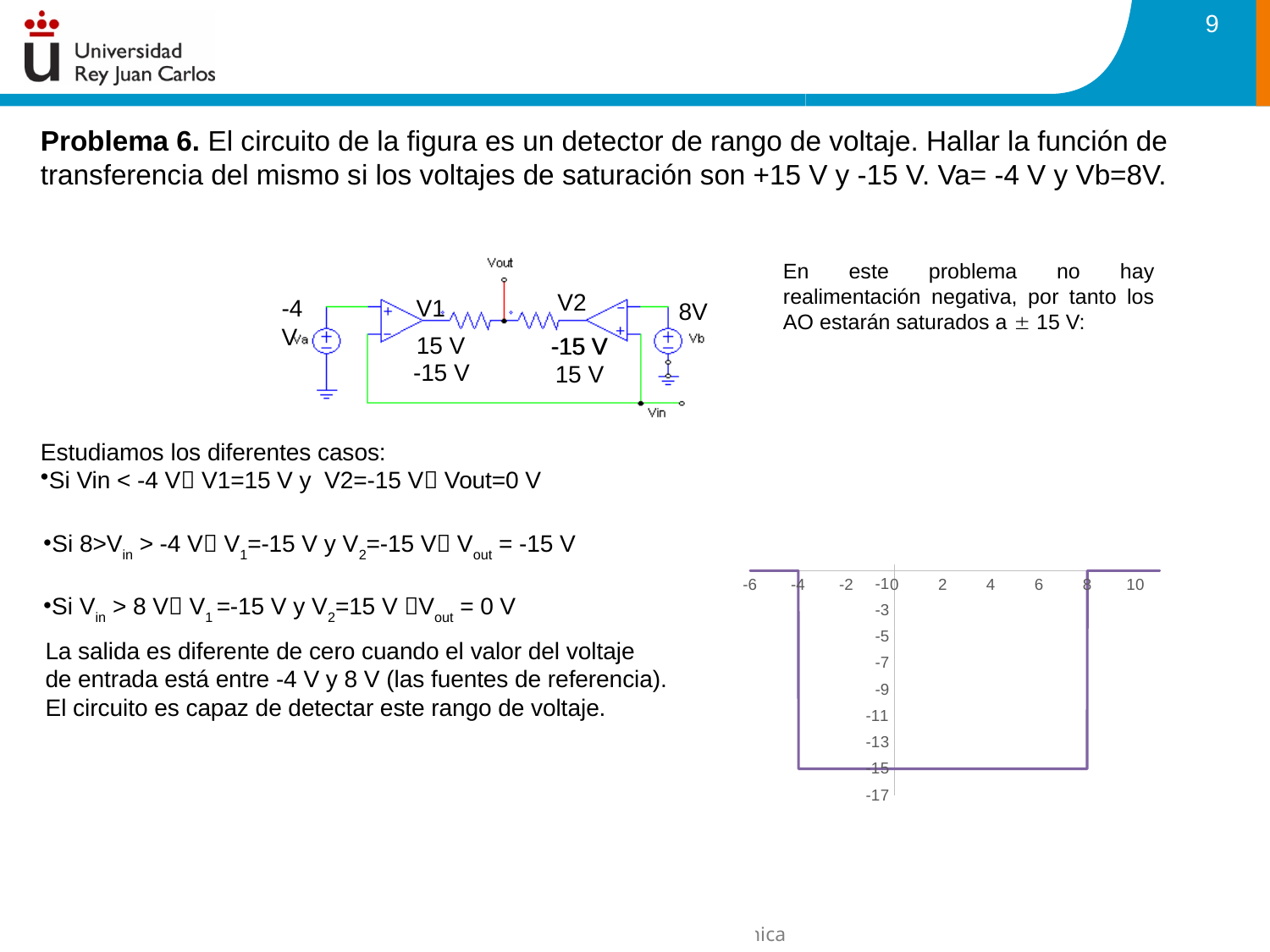
In the chart at the bottom right, what is the value of the line at Vin = 4? -15 In the chart at the bottom right, is the value of the line at Vin = 2 greater or less than -10? less In the chart at the bottom right, what is the lowest value the line reaches? -15 In the chart at the bottom right, at which x-axis value does the line rise back up from -15? 8 In the chart at the bottom right, at which x-axis value does the line drop from the top level down to -15? -4 In the chart at the bottom right, does the line rise, fall or stay flat between Vin = -2 and Vin = 6? stays flat In the chart at the bottom right, which is larger: the value of the line at Vin = -6 or at Vin = 0? Vin = -6 In the chart at the bottom right, is the value of the line at Vin = 6 greater or less than -5? less In the chart at the bottom right, what is the highest tick shown on the x axis? 10 In the chart at the bottom right, is the value of the line at Vin = 10 greater or less than -5? greater What kind of chart is shown at the bottom right of the slide? line chart In the chart at the bottom right, what is the lowest tick shown on the y axis? -17